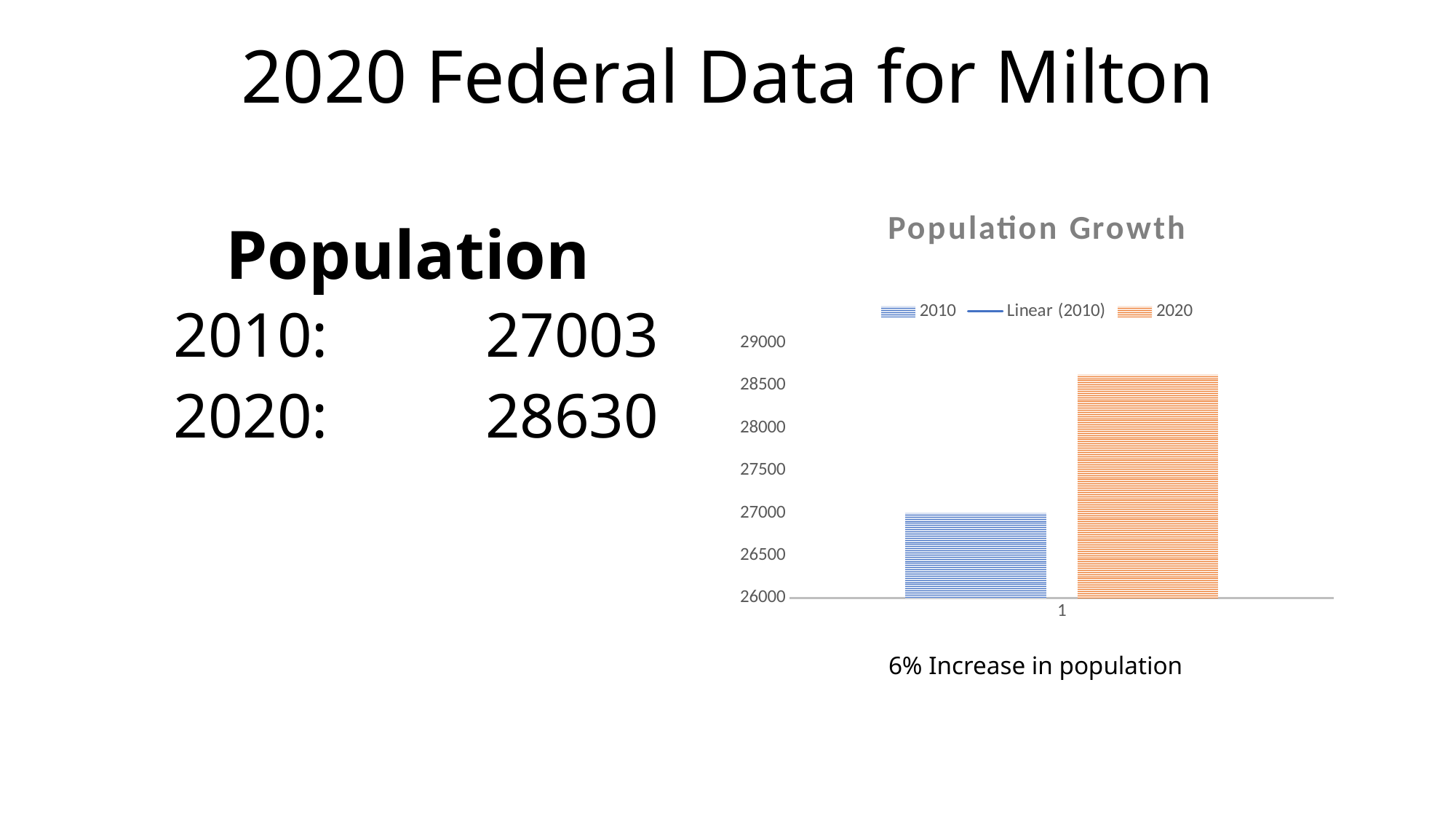
According to the slide, what is the population value for 2010? 27003 What is the difference between the 2020 and 2010 population values given on the slide? 1627 Is the value of the 2020 bar greater or less than 28500? greater Which series has the taller bar, 2010 or 2020? 2020 What kind of chart is shown on the slide? bar chart Which series has the lowest bar in the chart? 2010 Is the value of the 2010 bar greater or less than 27500? less What is the title of the chart? Population Growth According to the slide, what is the population value for 2020? 28630 How many bars are plotted in the chart? 2 Which series has the highest bar in the chart? 2020 How many entries does the chart legend list? 3